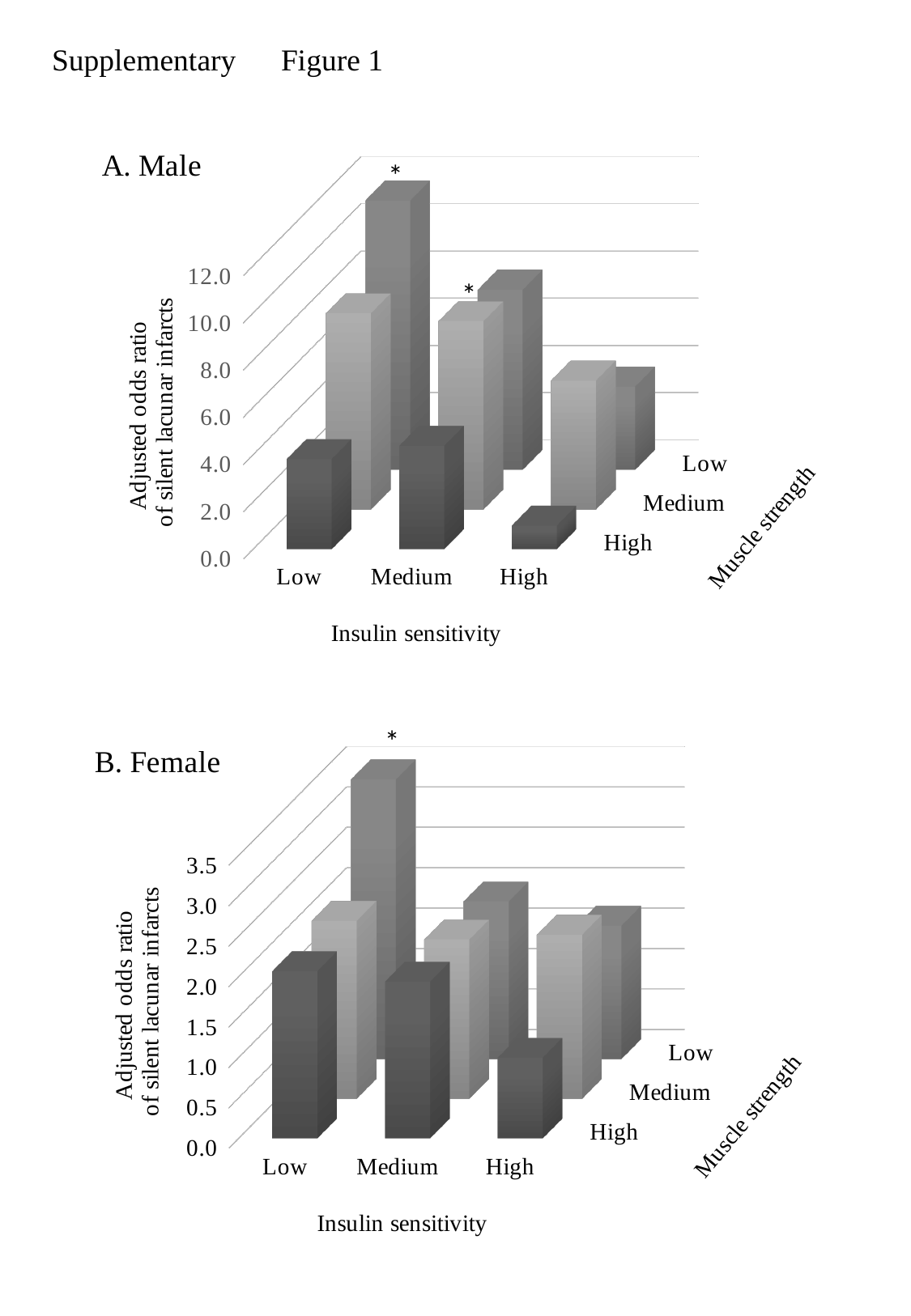
In the A. Male chart, is the adjusted odds ratio for High insulin sensitivity with High muscle strength greater or less than 2.0? less What kind of chart is used in panel A. Male? bar chart What is the y-axis title of the B. Female chart? Adjusted odds ratio of silent lacunar infarcts In the B. Female chart, which combination of insulin sensitivity and muscle strength has the highest adjusted odds ratio? Low insulin sensitivity, Low muscle strength In the A. Male chart, which combination of insulin sensitivity and muscle strength has the lowest adjusted odds ratio? High insulin sensitivity, High muscle strength In the B. Female chart, how many muscle strength levels are shown? 3 In the B. Female chart, is the adjusted odds ratio for Medium insulin sensitivity with Low muscle strength greater or less than 3.5? less How many charts are shown on the slide? 2 In the A. Male chart, which combination of insulin sensitivity and muscle strength has the highest adjusted odds ratio? Low insulin sensitivity, Low muscle strength In the A. Male chart, is the adjusted odds ratio for Medium insulin sensitivity with Low muscle strength greater or less than 12.0? less In the A. Male chart, how many insulin sensitivity categories are shown on the x axis? 3 In the A. Male chart, which is larger: the adjusted odds ratio for Medium insulin sensitivity with Low muscle strength, or for Low insulin sensitivity with Low muscle strength? Low insulin sensitivity with Low muscle strength